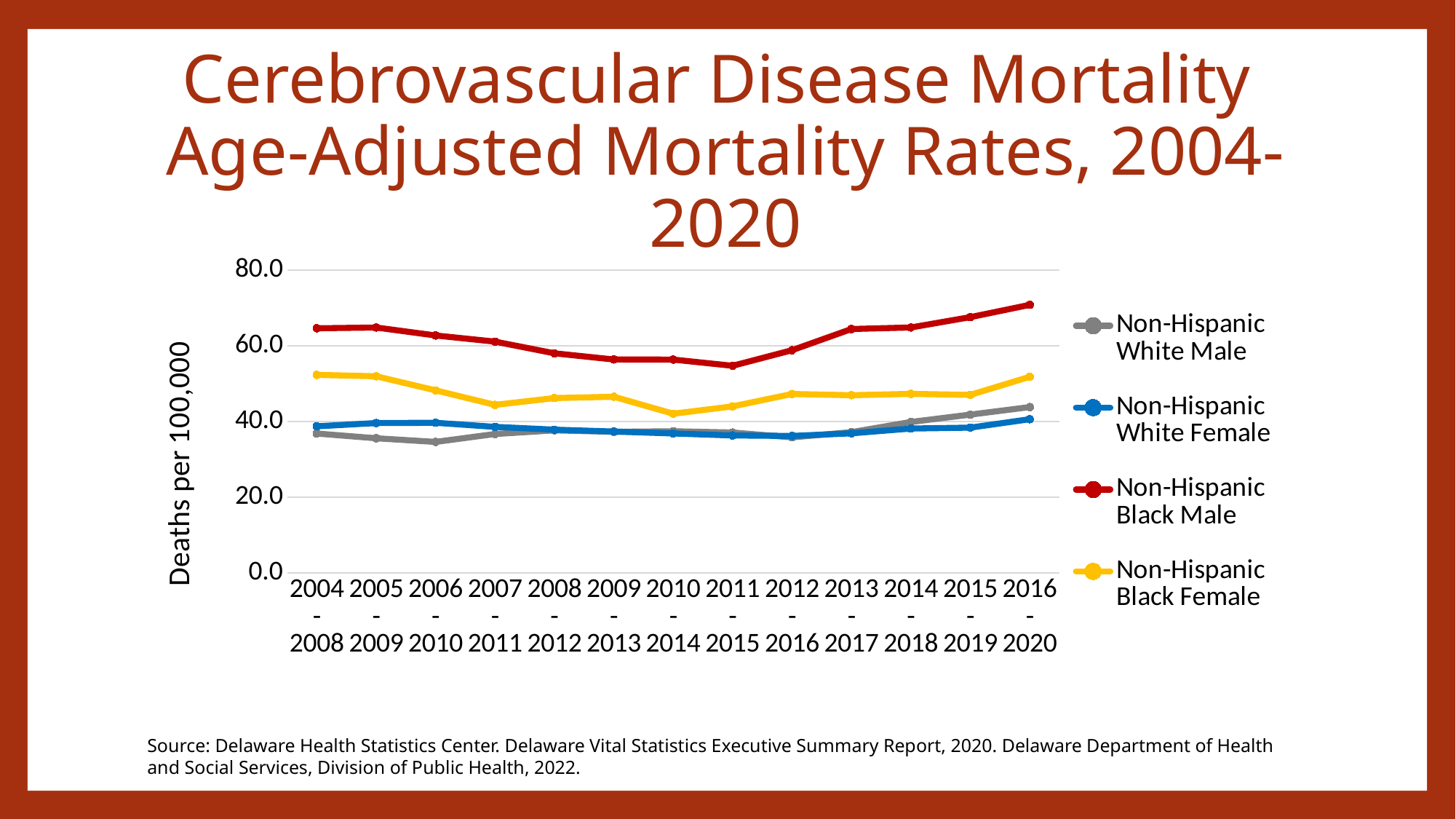
How many series does the legend list? 4 Is the value for Non-Hispanic Black Female in 2010-2014 greater or less than 60? less In 2004-2008, which is larger: the value for Non-Hispanic Black Male or Non-Hispanic White Female? Non-Hispanic Black Male How many time periods are plotted along the x axis? 13 Which series has the lowest value in the 2006-2010 period? Non-Hispanic White Male Is the value for Non-Hispanic White Male in 2006-2010 greater or less than 40? less Does the Non-Hispanic Black Male line rise or fall from 2011-2015 to 2016-2020? Rises What is the label on the y axis? Deaths per 100,000 Is the value for Non-Hispanic Black Male in 2016-2020 greater or less than 60? greater Which series has the highest mortality rate across the whole chart? Non-Hispanic Black Male What kind of chart is shown on the slide? Line chart